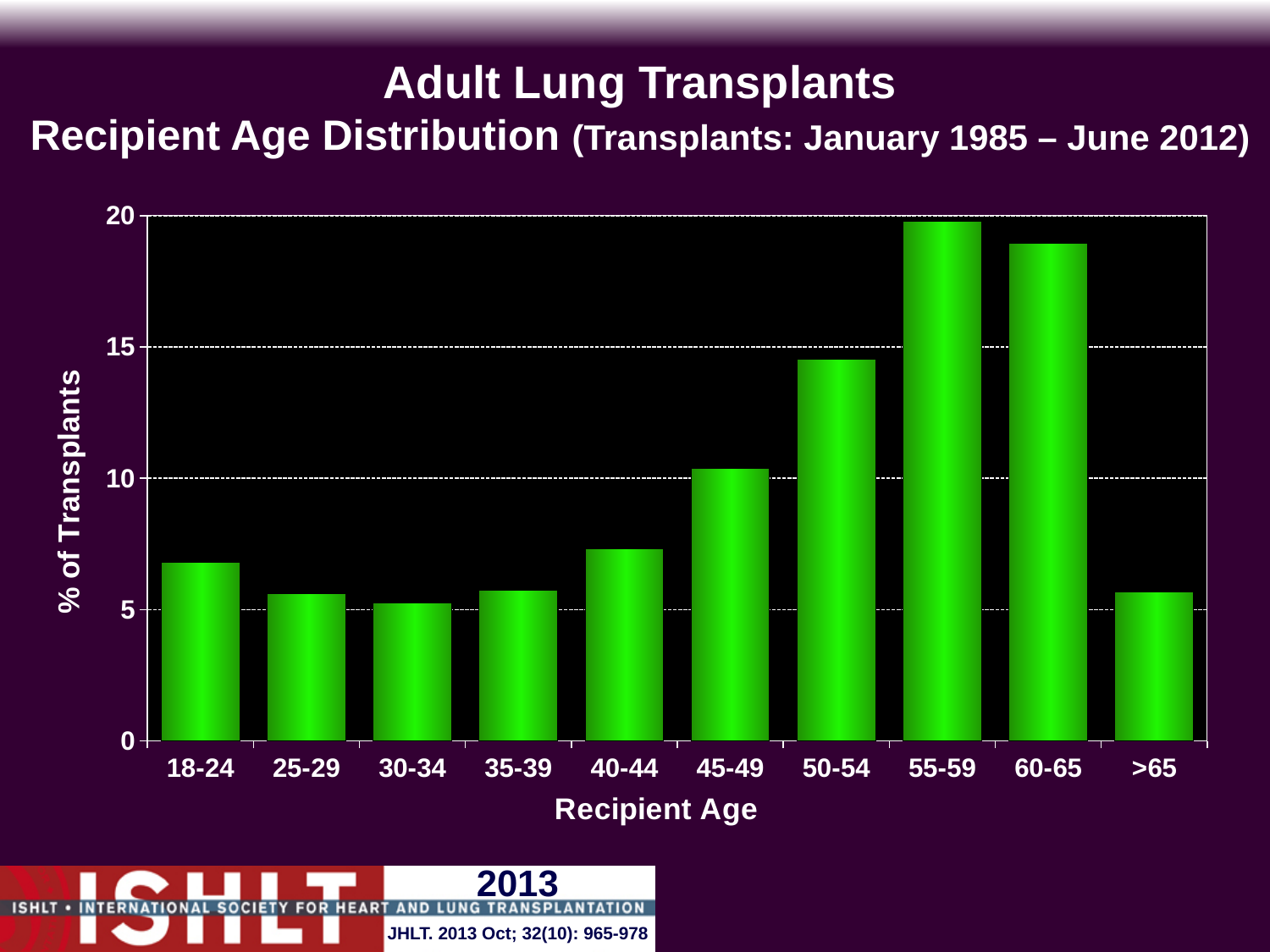
Is the value for the 18-24 age group greater or less than 5? greater Is the value for the 60-65 age group greater or less than 15? greater Is the value for the 25-29 age group greater or less than 10? less Which recipient age group has the highest % of transplants? 55-59 How many recipient age categories are shown on the x axis? 10 Which has a higher % of transplants, the 60-65 age group or the >65 age group? 60-65 What kind of chart is shown on the slide? bar chart What is the label of the y axis? % of Transplants Which has a higher % of transplants, the 50-54 age group or the 45-49 age group? 50-54